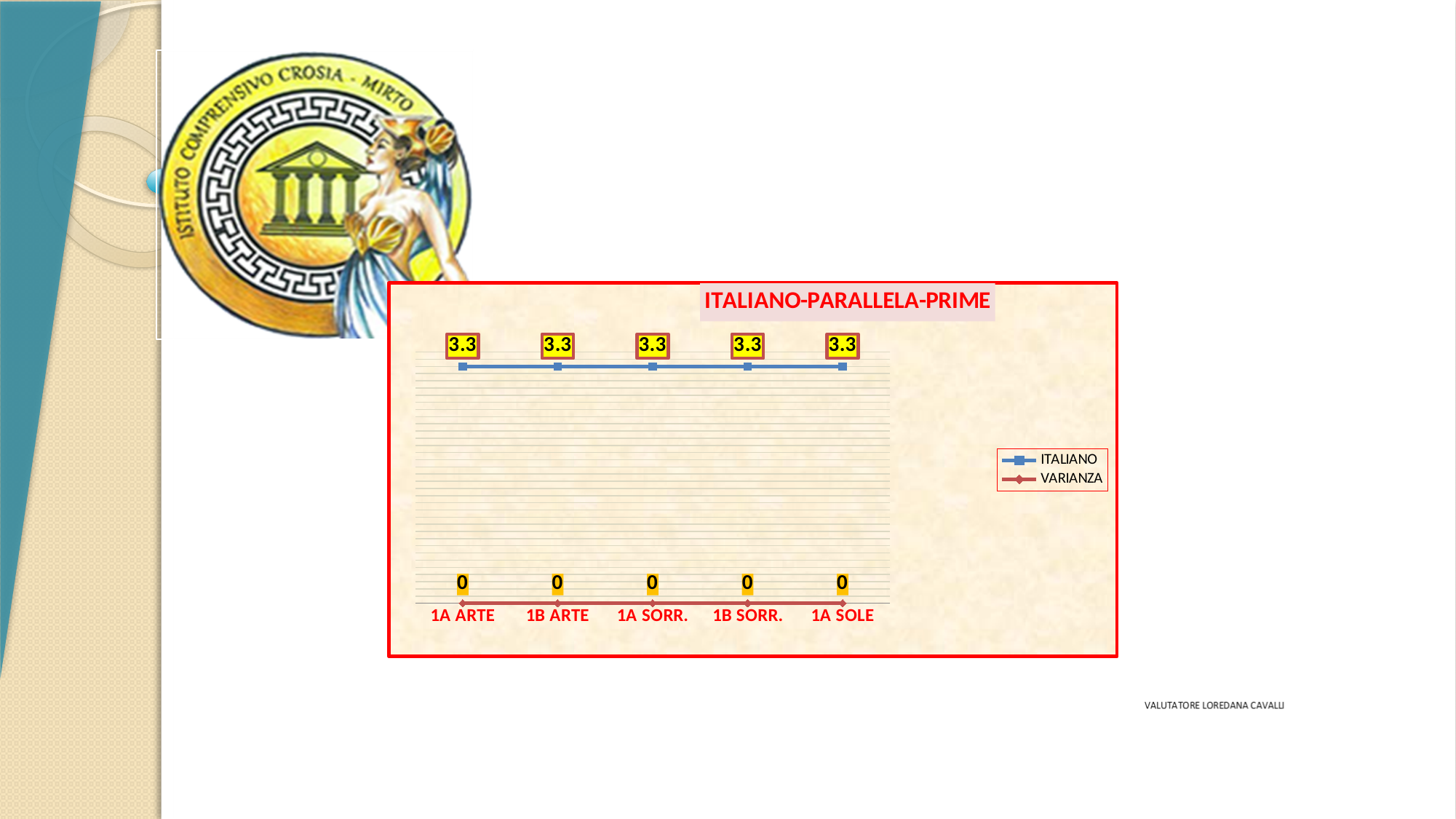
What kind of chart is shown on the slide? line chart How many categories are shown on the x axis? 5 Do the ITALIANO values rise, fall or stay flat across the categories from 1A ARTE to 1A SOLE? stay flat What is the VARIANZA value for 1A SORR.? 0 What is the VARIANZA value for 1B SORR.? 0 How many series does the legend list? 2 What is the difference between the ITALIANO and VARIANZA values for 1B ARTE? 3.3 Which series are listed in the legend? ITALIANO and VARIANZA Which is larger for 1A SOLE, the ITALIANO value or the VARIANZA value? ITALIANO What is the ITALIANO value for 1A ARTE? 3.3 What is the title of the chart? ITALIANO-PARALLELA-PRIME What is the ITALIANO value for 1A SOLE? 3.3